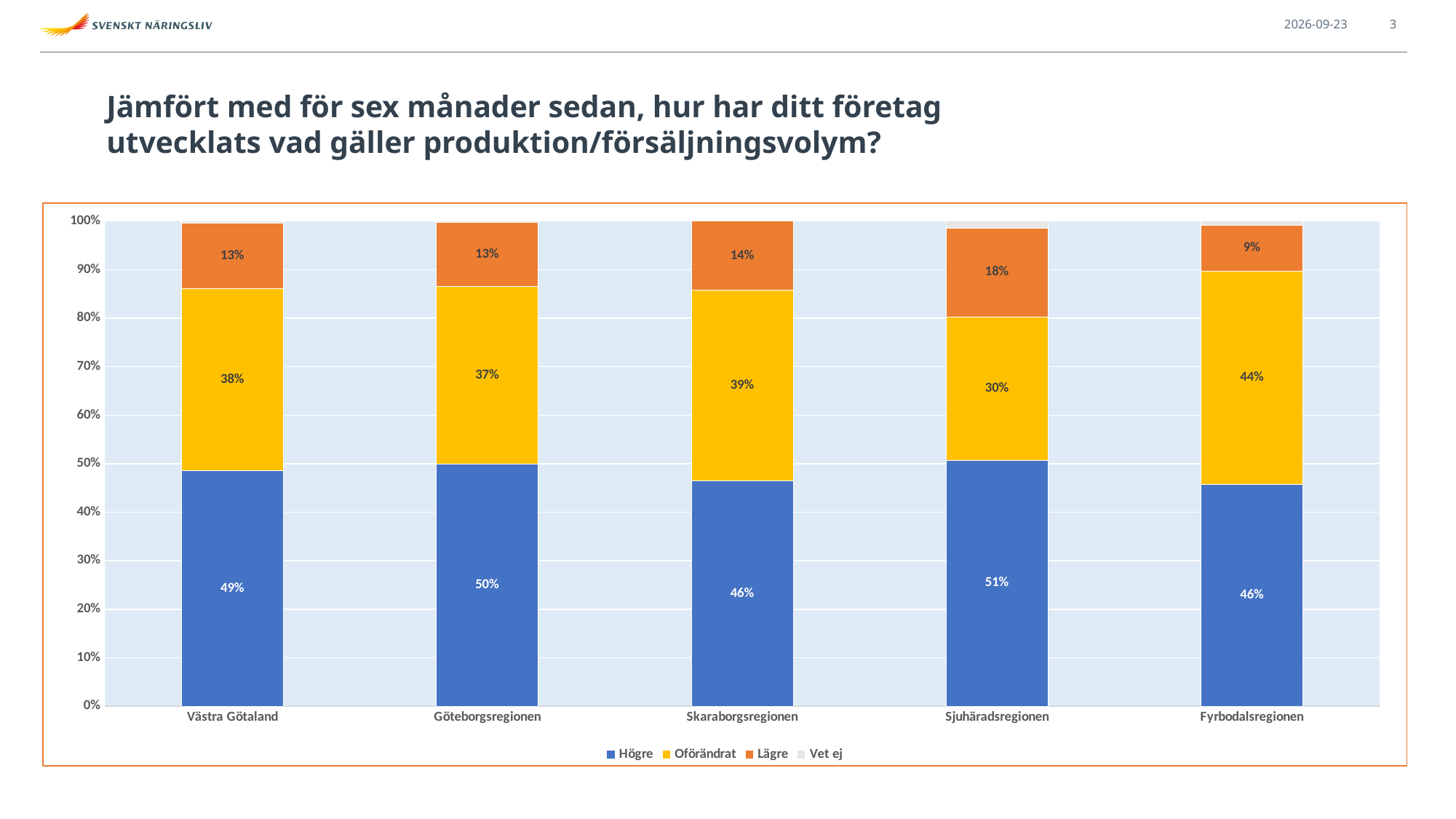
What is the Oförändrat value for Fyrbodalsregionen? 44% Which region has the lowest Lägre value? Fyrbodalsregionen How many regions are shown on the x axis of the chart? 5 What is the difference between the Oförändrat values for Fyrbodalsregionen and Sjuhäradsregionen? 14% What is the Lägre value for Skaraborgsregionen? 14% Which series is shown in orange in the chart legend? Lägre Which region has the lowest Oförändrat value? Sjuhäradsregionen How many series does the chart legend list? 4 Which region has the highest Lägre value? Sjuhäradsregionen What kind of chart is shown on the slide? Stacked bar chart What is the Högre value for Sjuhäradsregionen? 51% Which is larger, the Högre value for Göteborgsregionen or for Skaraborgsregionen? Göteborgsregionen